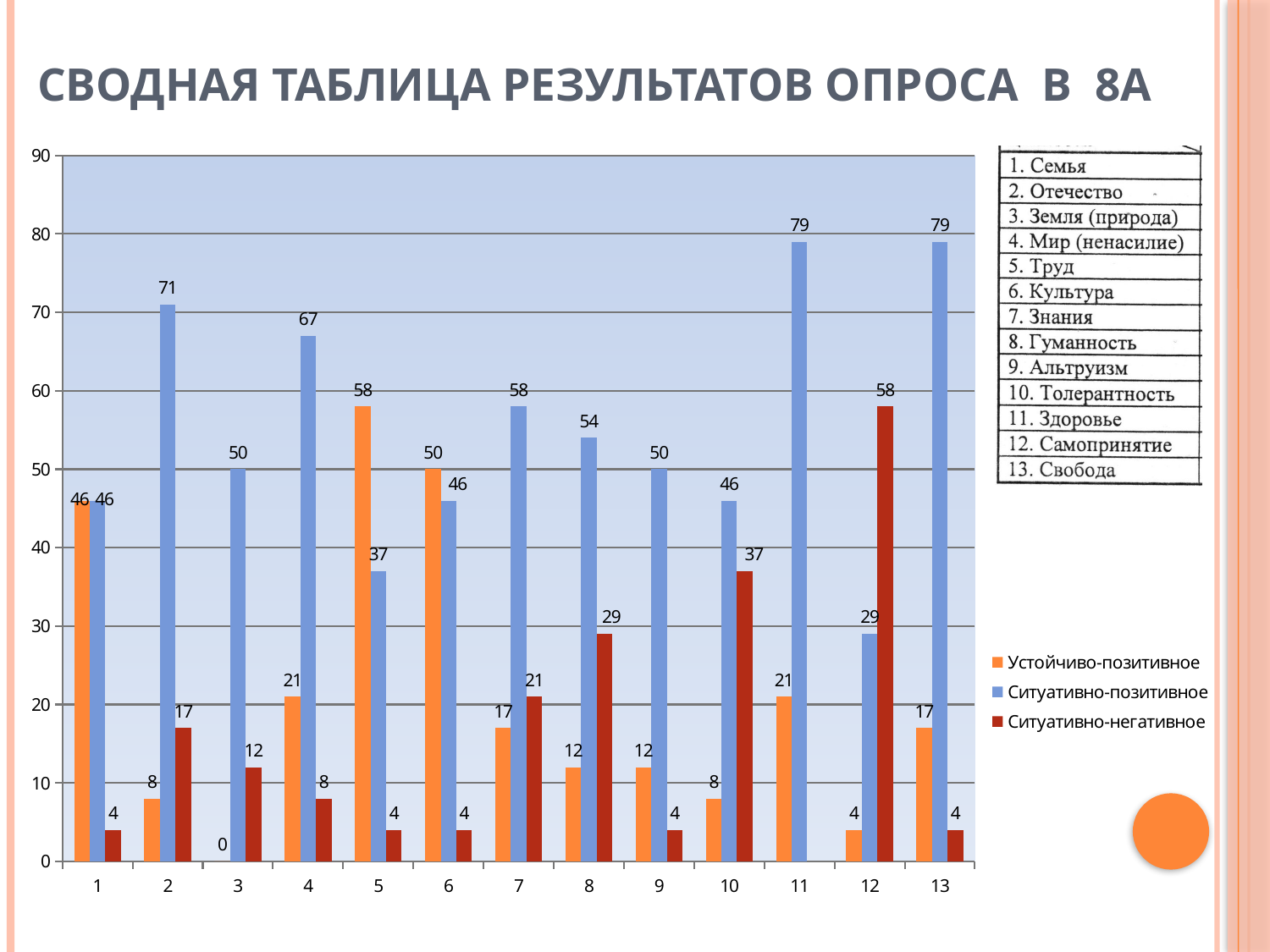
What is the value of Ситуативно-негативное for category 12? 58 How many categories are shown on the x axis? 13 Which category has the highest value for Ситуативно-негативное? 12 What type of chart is shown on the slide? bar chart For category 10, which is larger: Ситуативно-позитивное or Ситуативно-негативное? Ситуативно-позитивное Which category has the highest value for Устойчиво-позитивное? 5 Which series is shown in orange in the legend? Устойчиво-позитивное What is the difference between Ситуативно-позитивное and Устойчиво-позитивное for category 4? 46 How many series does the legend list? 3 Which category has the lowest value for Устойчиво-позитивное? 3 What is the value of Ситуативно-позитивное for category 2? 71 What is the value of Устойчиво-позитивное for category 5? 58